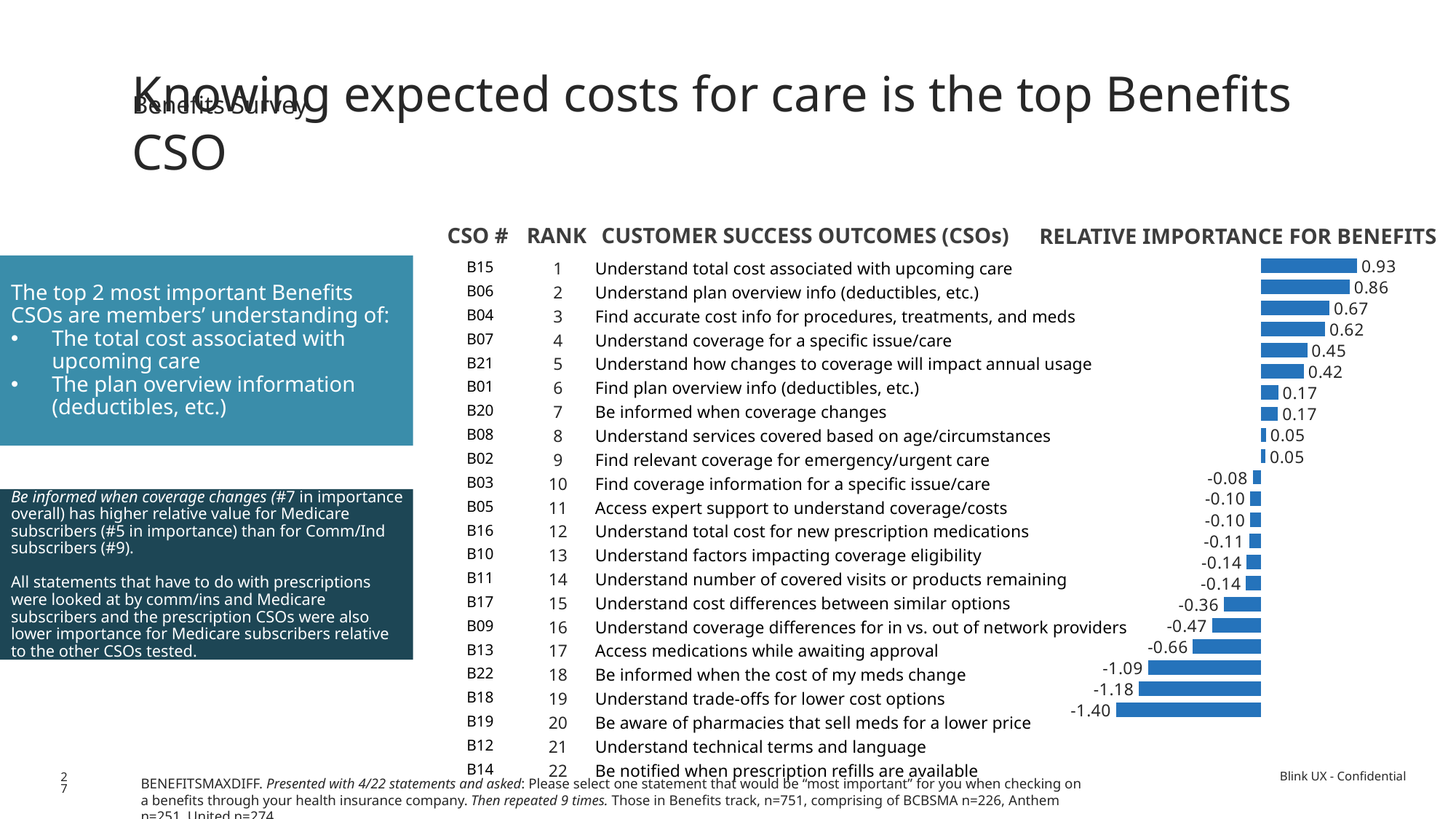
How many bars are plotted in the Relative Importance for Benefits chart? 22 How many bars in the chart have a negative relative importance value? 12 What is the lowest relative importance value shown in the chart? -1.40 What type of chart is shown under 'Relative Importance for Benefits'? bar chart Which CSO has the highest relative importance for Benefits? B15 (Understand total cost associated with upcoming care) What is the difference between the relative importance values of the rank 1 bar (0.93) and the rank 2 bar (0.86)? 0.07 What is the relative importance value for the rank 3 CSO, B04 'Find accurate cost info for procedures, treatments, and meds'? 0.67 What is the relative importance value for the top-ranked CSO, B15 'Understand total cost associated with upcoming care'? 0.93 What is the relative importance value for the rank 2 CSO, B06 'Understand plan overview info (deductibles, etc.)'? 0.86 Which is larger: the relative importance for rank 5 (B21) or rank 6 (B01)? rank 5 (B21), 0.45 Do the relative importance values rise or fall going down the chart from rank 1 to rank 22? fall What is the relative importance value for the rank 21 CSO, B12 'Understand technical terms and language'? -1.18